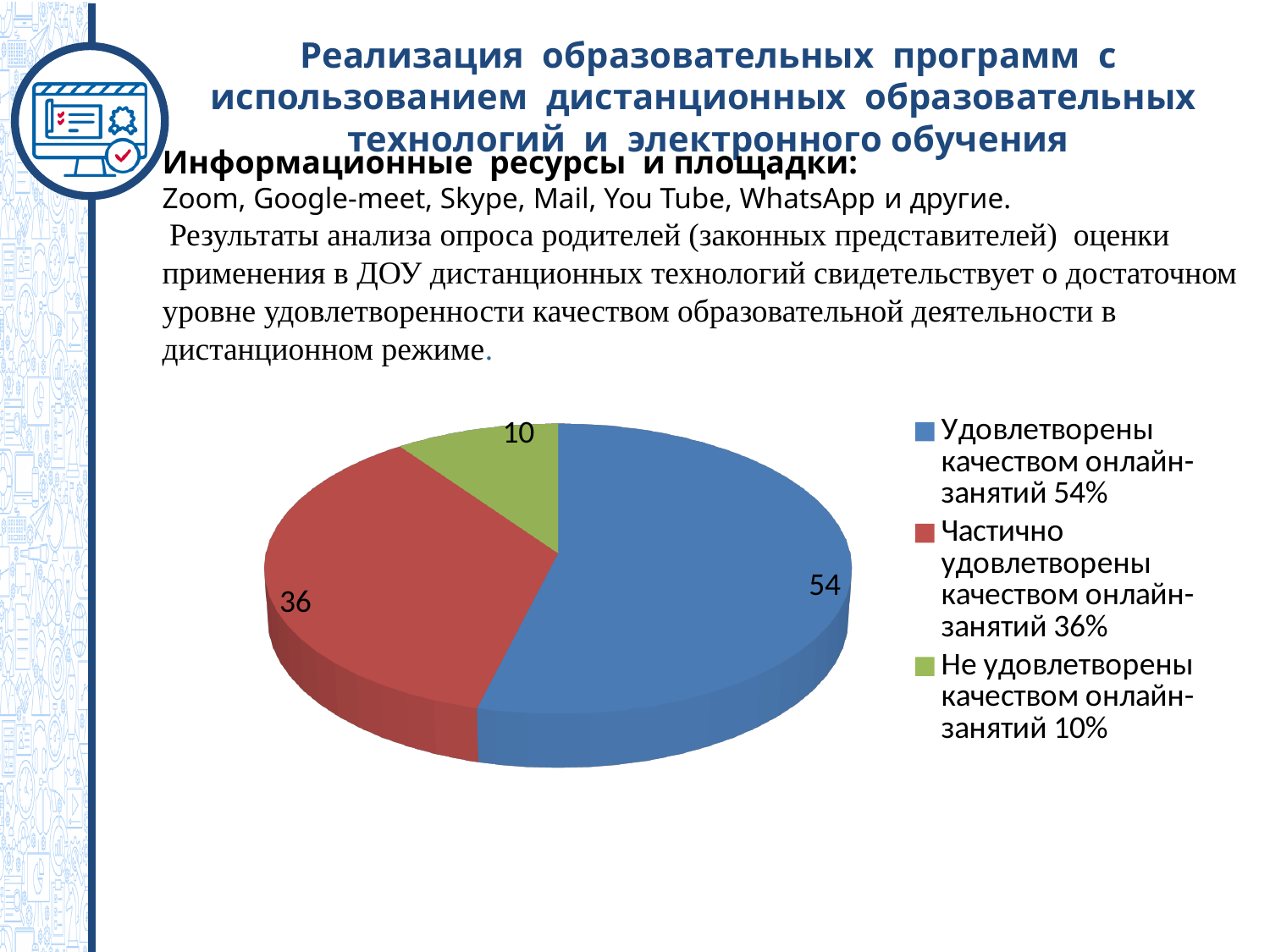
What is the difference between the values for "Удовлетворены" and "Частично удовлетворены"? 18 What is the difference between the values for "Частично удовлетворены" and "Не удовлетворены"? 26 What value is shown for the slice "Не удовлетворены качеством онлайн-занятий"? 10 Which category has the smallest slice of the pie? Не удовлетворены качеством онлайн-занятий What share of the pie does the "Удовлетворены качеством онлайн-занятий" slice represent? 54% Which is larger: the slice for "Частично удовлетворены" or the slice for "Не удовлетворены"? Частично удовлетворены Which category has the largest slice of the pie? Удовлетворены качеством онлайн-занятий How many slices does the pie chart have? 3 What kind of chart is shown on the slide? Pie chart What value is shown for the slice "Удовлетворены качеством онлайн-занятий"? 54 What colour is the slice for "Не удовлетворены качеством онлайн-занятий"? Green What value is shown for the slice "Частично удовлетворены качеством онлайн-занятий"? 36